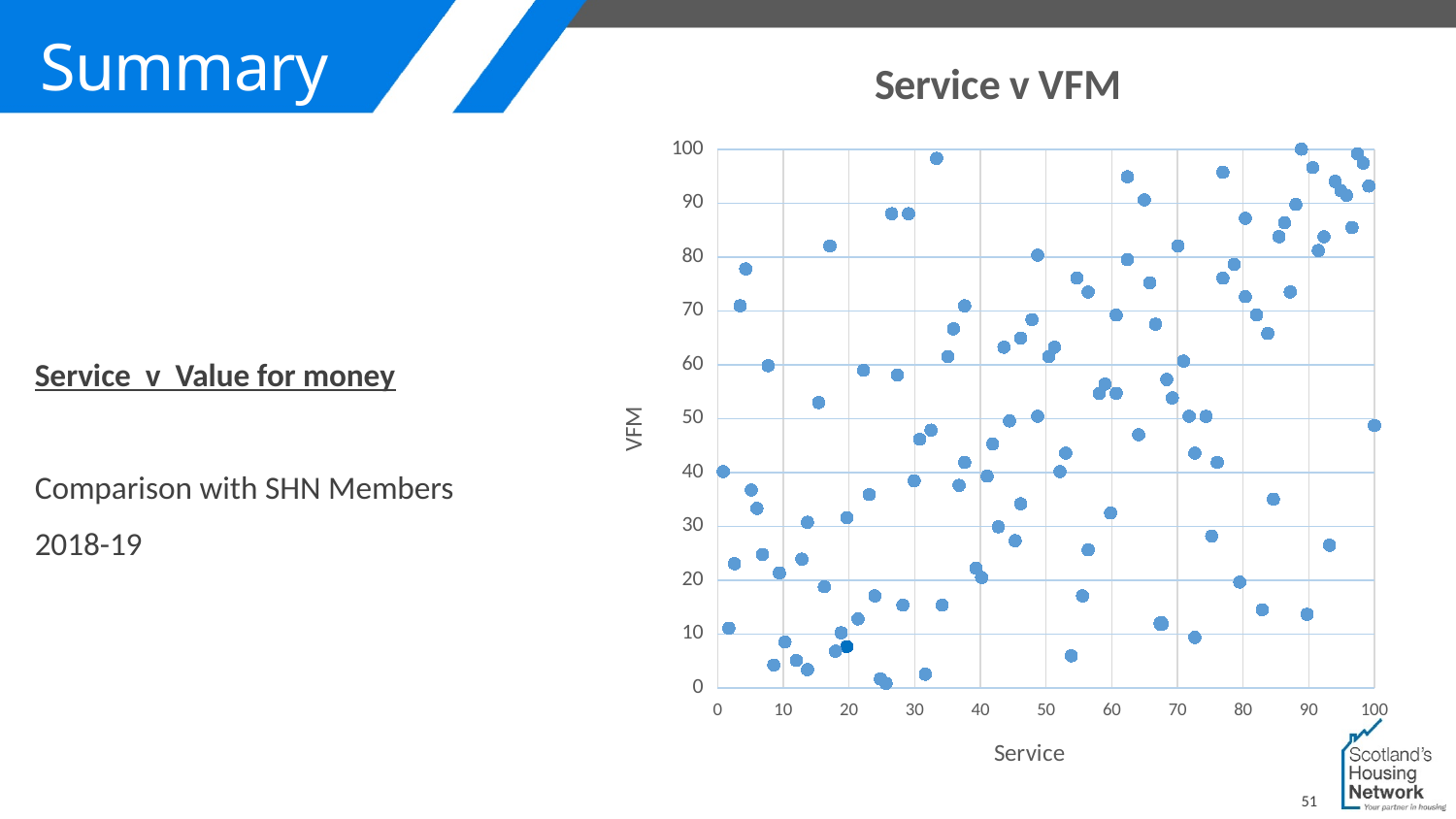
What label is shown on the vertical axis of the chart? VFM What kind of chart is shown on the slide? Scatter chart What is the title of the chart? Service v VFM Do the VFM values generally rise or fall as Service increases along the x axis? Rise